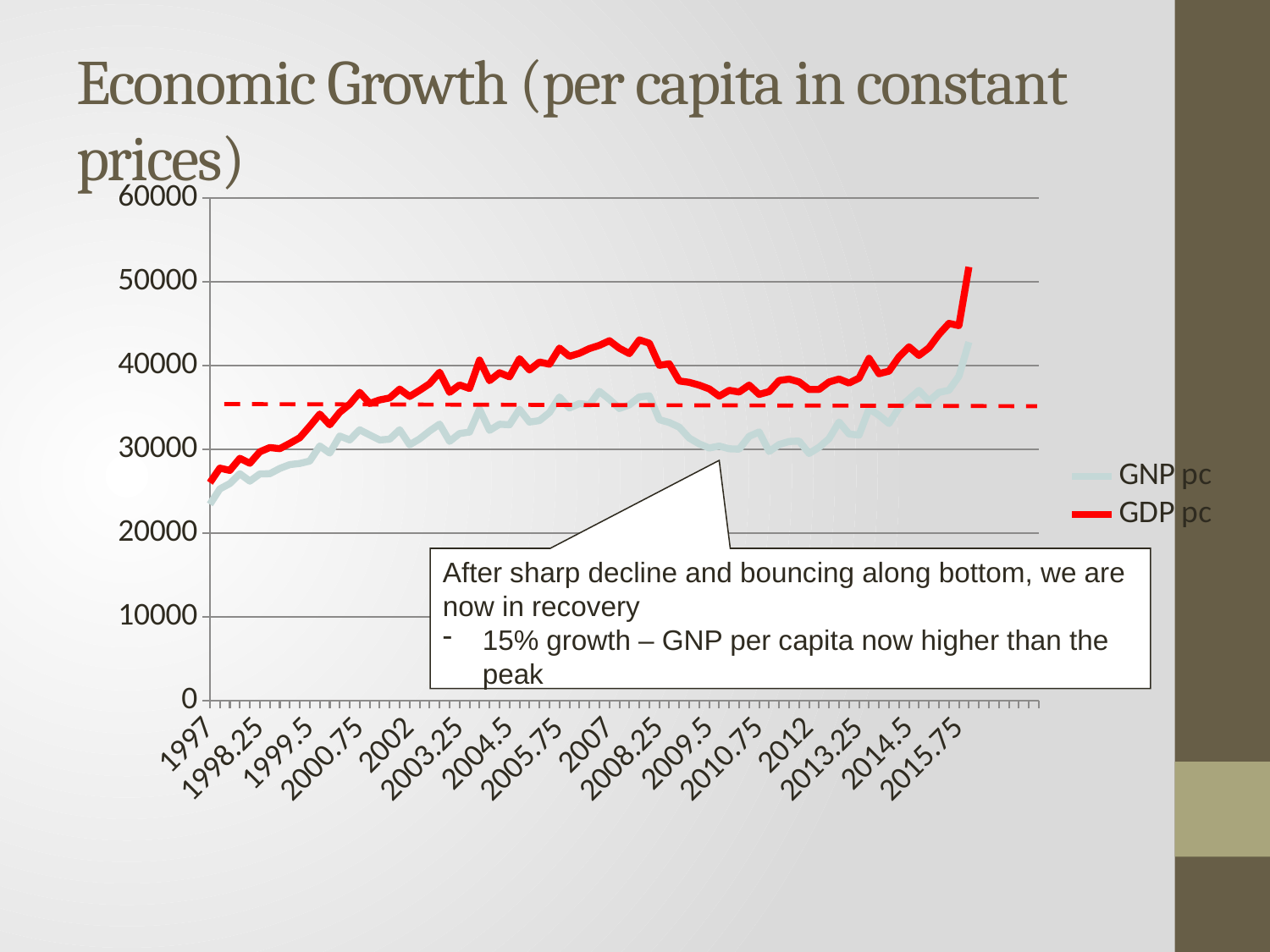
How many series does the legend list? 2 What is the title of the chart on the slide? Economic Growth (per capita in constant prices) Is the value of GNP pc at 2007 greater or less than 40000? less Is the final value of GDP pc at the right end of the chart greater or less than 40000? greater Is the value of GNP pc at 1997 greater or less than 30000? less Do the values of GDP pc rise or fall between 1997 and 2007? rise Which series reaches the highest value on the chart? GDP pc What type of chart is shown on the slide? line chart At 2007, which series has the higher value, GNP pc or GDP pc? GDP pc What are the two series named in the legend? GNP pc and GDP pc